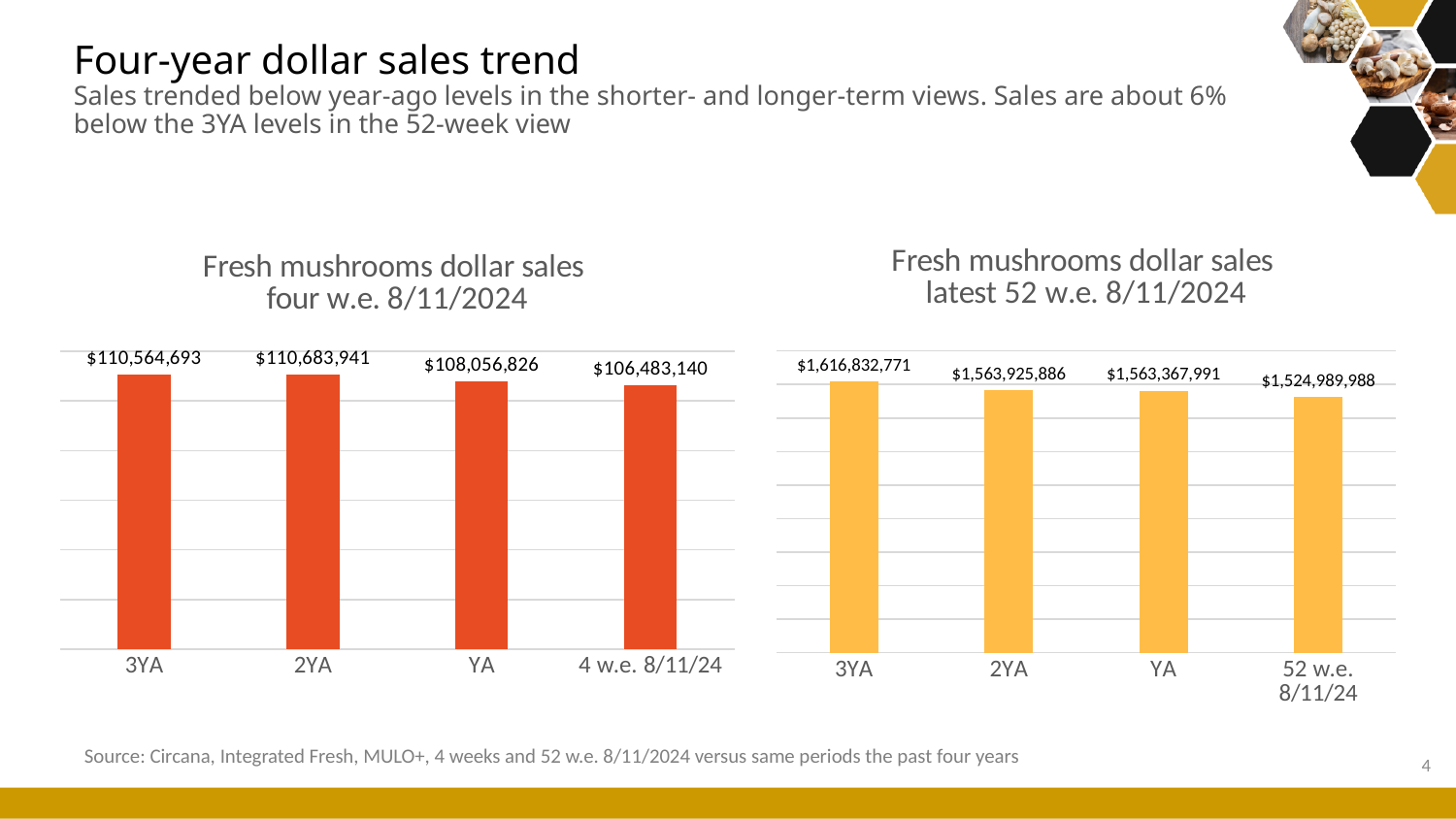
In the 'Fresh mushrooms dollar sales latest 52 w.e. 8/11/2024' chart, which period has the highest value? 3YA What kind of chart is the 'Fresh mushrooms dollar sales four w.e. 8/11/2024' chart? Bar chart In the 'Fresh mushrooms dollar sales four w.e. 8/11/2024' chart, what is the value for YA? $108,056,826 In the 'Fresh mushrooms dollar sales four w.e. 8/11/2024' chart, which is larger, the value for 3YA or the value for 4 w.e. 8/11/24? 3YA In the 'Fresh mushrooms dollar sales latest 52 w.e. 8/11/2024' chart, what is the value for 3YA? $1,616,832,771 In the 'Fresh mushrooms dollar sales latest 52 w.e. 8/11/2024' chart, do the values rise or fall from 3YA to 52 w.e. 8/11/24? Fall In the 'Fresh mushrooms dollar sales latest 52 w.e. 8/11/2024' chart, what is the value for 52 w.e. 8/11/24? $1,524,989,988 In the 'Fresh mushrooms dollar sales four w.e. 8/11/2024' chart, what is the difference between the 2YA value and the YA value? $2,627,115 How many periods are shown in the 'Fresh mushrooms dollar sales latest 52 w.e. 8/11/2024' chart? 4 In the 'Fresh mushrooms dollar sales four w.e. 8/11/2024' chart, what is the value for 4 w.e. 8/11/24? $106,483,140 In the 'Fresh mushrooms dollar sales four w.e. 8/11/2024' chart, which period has the lowest value? 4 w.e. 8/11/24 In the 'Fresh mushrooms dollar sales latest 52 w.e. 8/11/2024' chart, what is the difference between the 3YA value and the 52 w.e. 8/11/24 value? $91,842,783